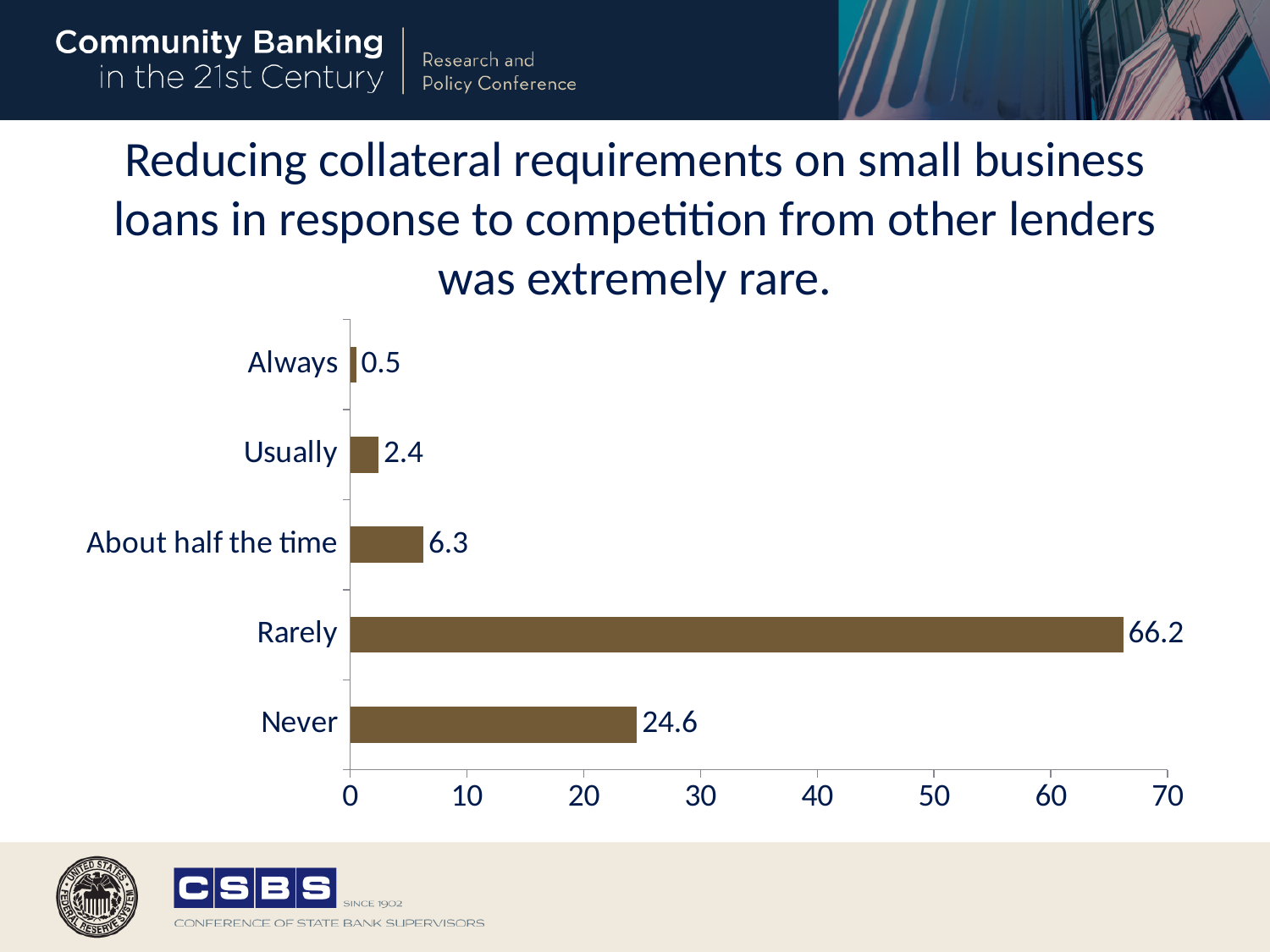
Which category has the highest value? Rarely What is the maximum value shown on the horizontal axis? 70 How many categories are shown in the chart? 5 Is the value for Never greater or less than 20? greater What is the value for Never? 24.6 Which category has the lowest value? Always What kind of chart is shown on the slide? Bar chart Which is larger, the value for Usually or the value for About half the time? About half the time What is the value for Always? 0.5 What is the value for Rarely? 66.2 What is the difference between the values for Rarely and Never? 41.6 What is the value for About half the time? 6.3